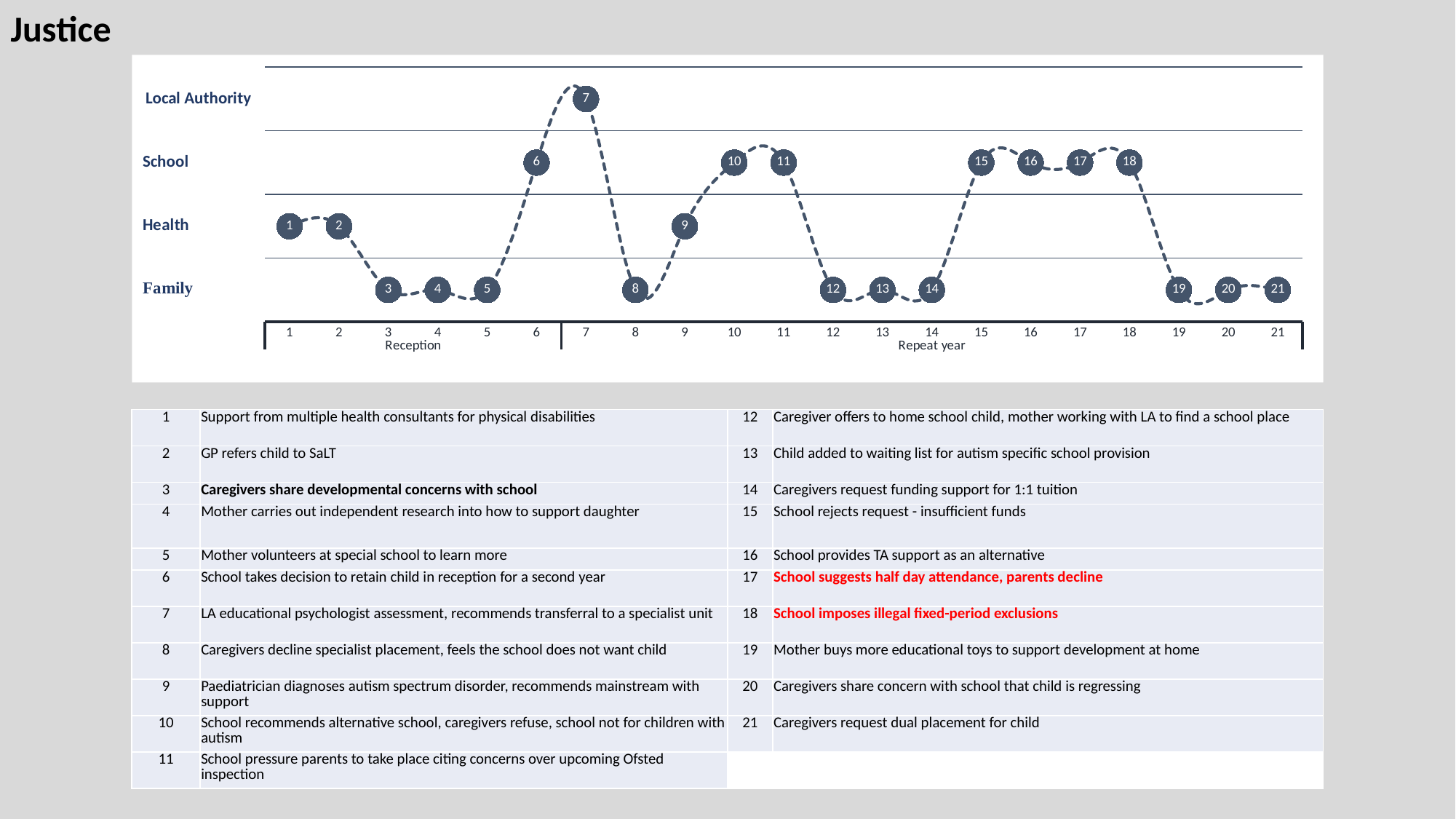
How many categories are listed on the vertical axis of the chart? 4 Which points are plotted on the Health row? 1, 2 and 9 Which vertical-axis category is point 13 plotted on? Family Which vertical-axis category is point 16 plotted on? School Which vertical-axis category is point 7 plotted on? Local Authority What type of chart is shown on the slide? Line chart Which is the only point plotted on the Local Authority row? 7 How many points are plotted on the Family row? 10 How many numbered points are plotted on the chart? 21 Which vertical-axis category is point 9 plotted on? Health What are the two phase labels shown beneath the x axis of the chart? Reception and Repeat year